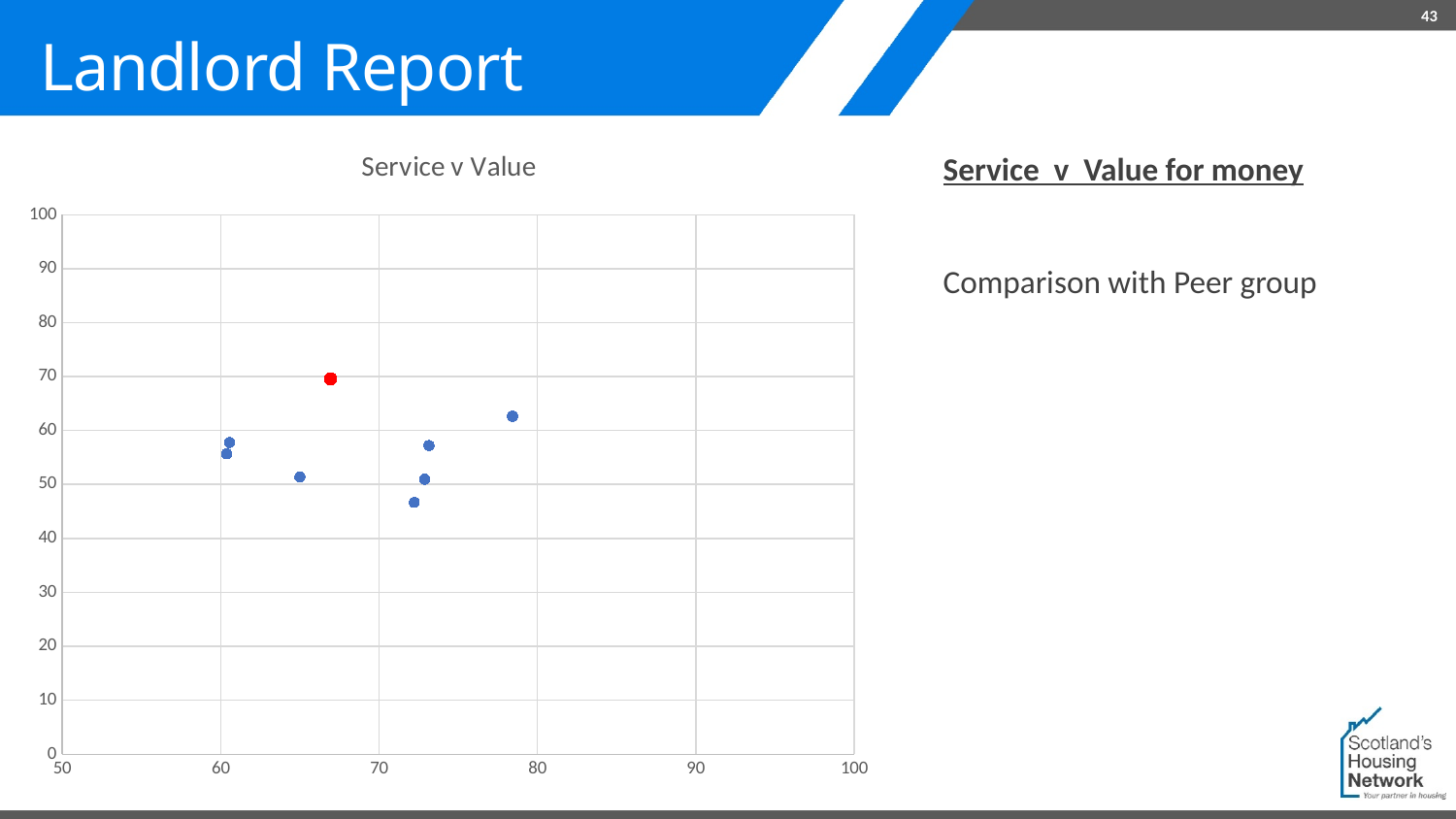
What is the title of the chart? Service v Value Is the vertical-axis value of the red point greater or less than 80? less Is the vertical-axis value of the red point greater or less than 60? greater How many data points are plotted on the chart? 8 Is the horizontal-axis value of the red point greater or less than 60? greater Which colour is the point with the highest vertical-axis value? Red What is the maximum value shown on the vertical axis? 100 How many points on the chart are coloured red? 1 What kind of chart is shown on the slide? Scatter chart How many points on the chart are coloured blue? 7